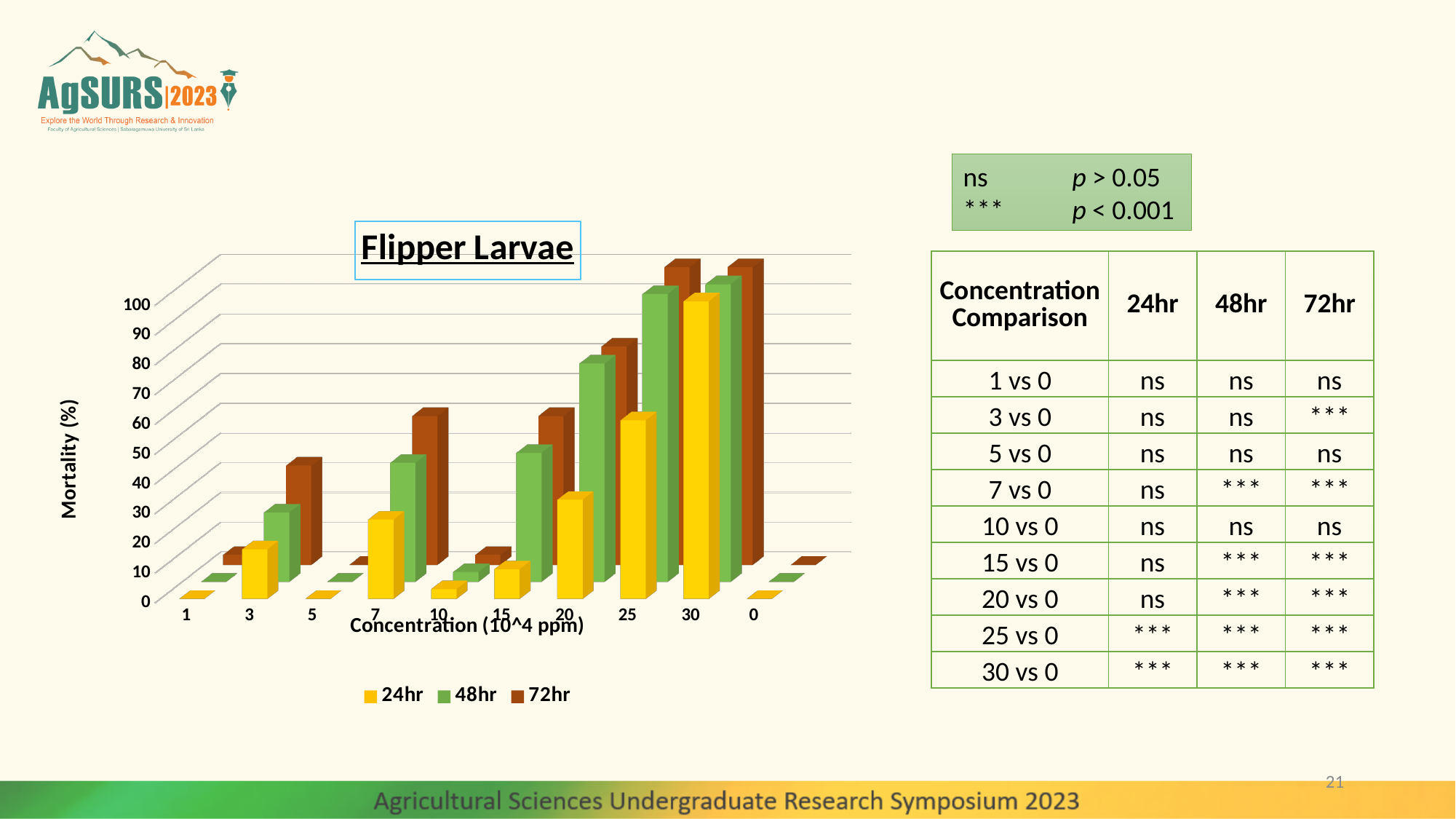
What kind of chart is shown on the slide? bar chart What is the label of the y axis of the chart? Mortality (%) Is the 24hr mortality at concentration 15 greater or less than 30? less Is the 24hr mortality at concentration 30 greater or less than 80? greater What is the title of the chart? Flipper Larvae How many concentration categories are shown on the x axis of the chart? 10 Which concentration has the highest 24hr mortality? 30 Which is larger: the 24hr mortality at concentration 25 or at concentration 30? 30 How many series does the chart legend list? 3 Which is larger: the 72hr mortality at concentration 3 or at concentration 7? 7 Going from concentration 1 to concentration 30, does the 24hr mortality generally rise or fall? rise Is the 48hr mortality at concentration 20 greater or less than 60? greater